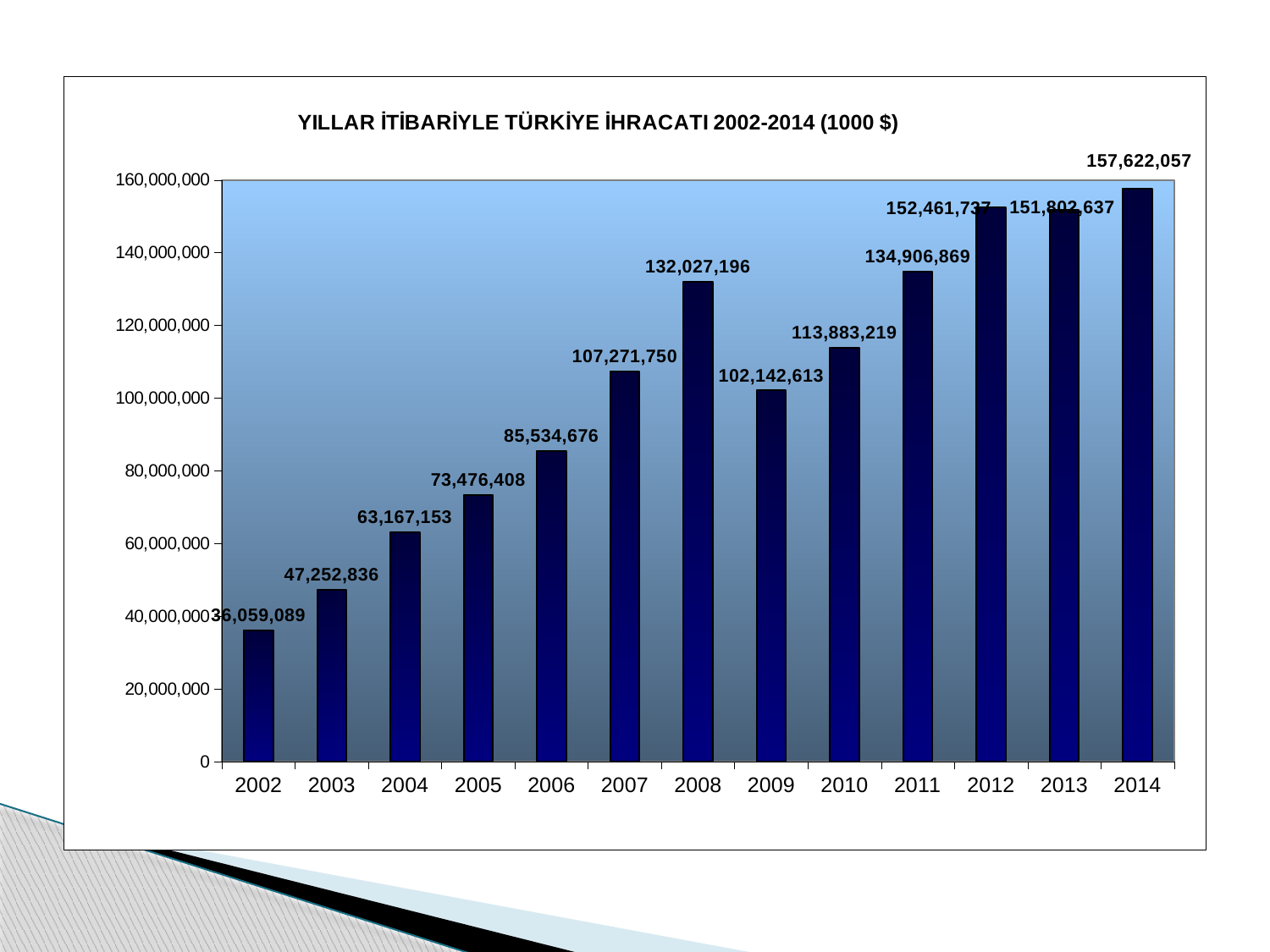
Which year has the highest value? 2014 How many years are shown on the x axis? 13 Is the value for 2002 greater or less than 40,000,000? less Which is larger, the value for 2008 or the value for 2009? 2008 What is the difference between the values for 2008 and 2007? 24,755,446 What is the value for 2008? 132,027,196 What is the value for 2005? 73,476,408 What kind of chart is this? bar chart Which year has the lowest value? 2002 What is the value for 2011? 134,906,869 What is the value for 2014? 157,622,057 What is the difference between the values for 2010 and 2009? 11,740,606